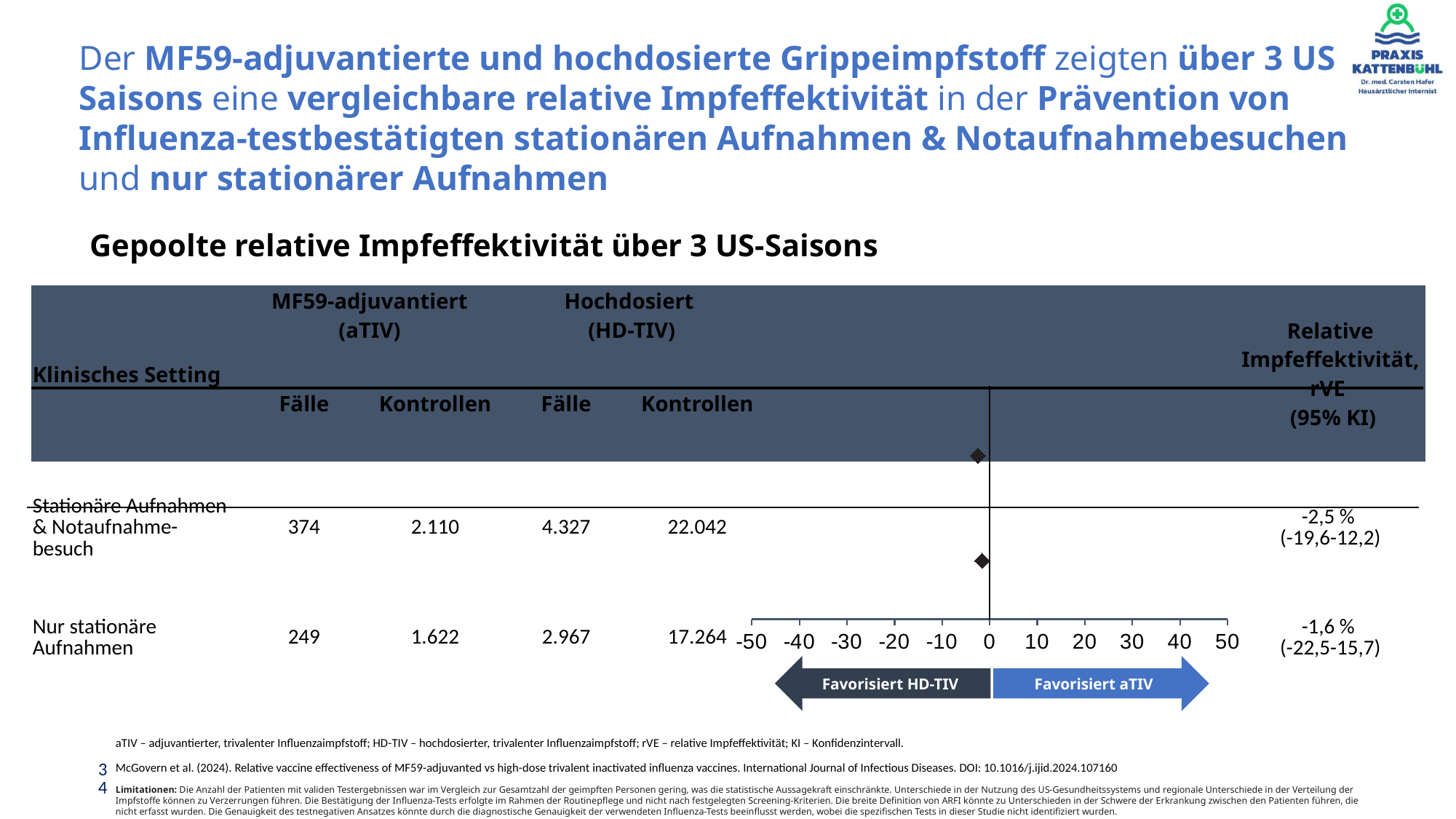
What are the minimum and maximum values shown on the x axis of the forest plot? -50 and 50 Which clinical setting has the higher rVE point estimate? Nur stationäre Aufnahmen What is the relative vaccine effectiveness (rVE) shown for 'Stationäre Aufnahmen & Notaufnahmebesuch'? -2,5 % How many point estimates (diamonds) are plotted in the forest plot? 2 How many MF59-adjuvanted (aTIV) cases (Fälle) are listed for 'Nur stationäre Aufnahmen'? 249 What is the 95% confidence interval printed for the rVE of 'Stationäre Aufnahmen & Notaufnahmebesuch'? -19,6-12,2 Is the rVE point estimate for 'Stationäre Aufnahmen & Notaufnahmebesuch' greater or less than 0? less What is the 95% confidence interval printed for the rVE of 'Nur stationäre Aufnahmen'? -22,5-15,7 Which vaccine does the left-pointing arrow below the x axis favour? HD-TIV What is the relative vaccine effectiveness (rVE) shown for 'Nur stationäre Aufnahmen'? -1,6 % What is the difference between the rVE point estimates of the two clinical settings? 0,9 percentage points How many high-dose (HD-TIV) controls (Kontrollen) are listed for 'Stationäre Aufnahmen & Notaufnahmebesuch'? 22.042